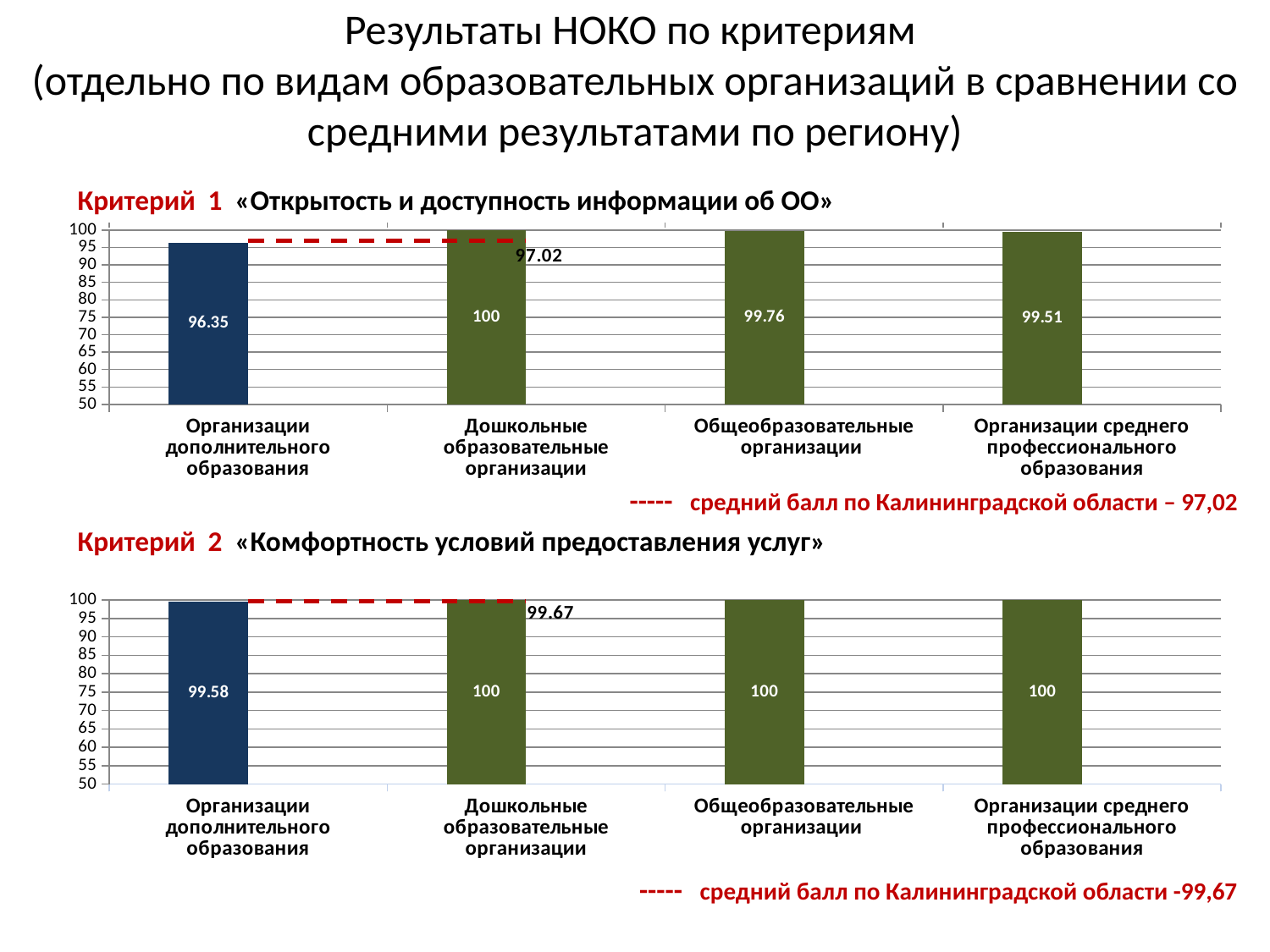
In the Критерий 1 chart, what is the difference between the values for Дошкольные образовательные организации and Организации дополнительного образования? 3.65 In the Критерий 1 chart, which category has the lowest value? Организации дополнительного образования In the Критерий 1 chart, which is larger: the value for Общеобразовательные организации or for Организации среднего профессионального образования? Общеобразовательные организации In the Критерий 2 chart, what is the value for Организации дополнительного образования? 99.58 In the Критерий 1 chart, what regional average value is marked by the dashed line? 97.02 In the Критерий 1 chart, what is the value for Общеобразовательные организации? 99.76 How many categories are shown in the Критерий 2 chart? 4 In the Критерий 1 chart, which category has the highest value? Дошкольные образовательные организации In the Критерий 2 chart, what is the value for Организации среднего профессионального образования? 100 In the Критерий 1 chart, what is the value for Организации дополнительного образования? 96.35 In the Критерий 2 chart, is the value for Организации дополнительного образования greater or less than 95? greater What type of chart is the Критерий 1 chart? Bar chart